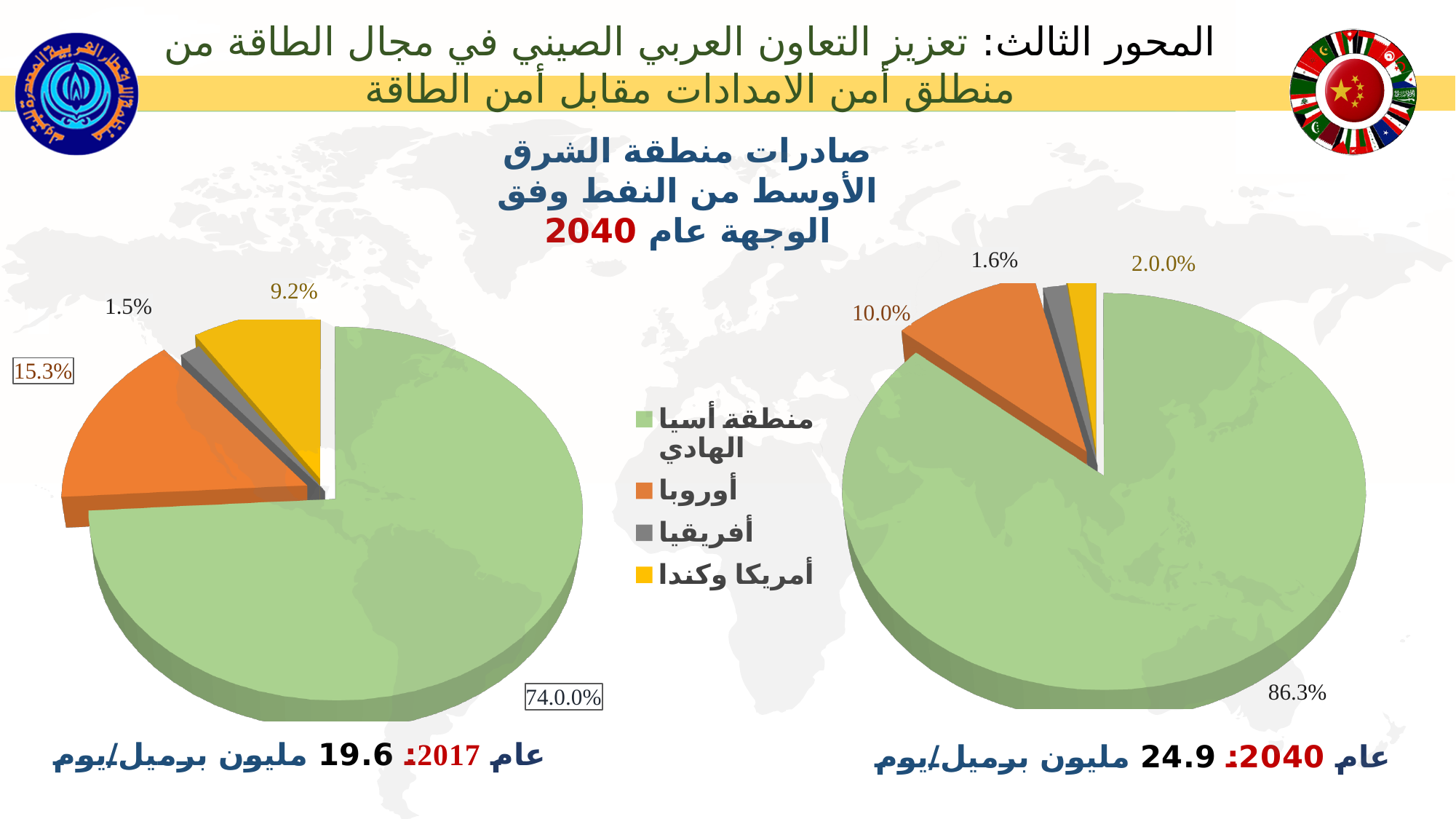
How many series does the legend list? 4 In the right pie chart (عام 2040), what share goes to أوروبا? 10.0% In the right pie chart (عام 2040), which destination has the smallest share? أفريقيا In the left pie chart (عام 2017), what share goes to أوروبا? 15.3% In the right pie chart (عام 2040), what share goes to أفريقيا? 1.6% In the left pie chart (عام 2017), which is larger: the share for أوروبا or the share for أمريكا وكندا? أوروبا What is the difference between the share for أوروبا in the left chart (عام 2017) and in the right chart (عام 2040)? 5.3% In the left pie chart (عام 2017), which destination has the largest share? منطقة أسيا الهادي In the right pie chart (عام 2040), what share goes to منطقة أسيا الهادي? 86.3% What type of chart is used on the left side of the slide (عام 2017)? pie chart In the left pie chart (عام 2017), what share goes to أفريقيا? 1.5% In the left pie chart (عام 2017), what share goes to أمريكا وكندا? 9.2%